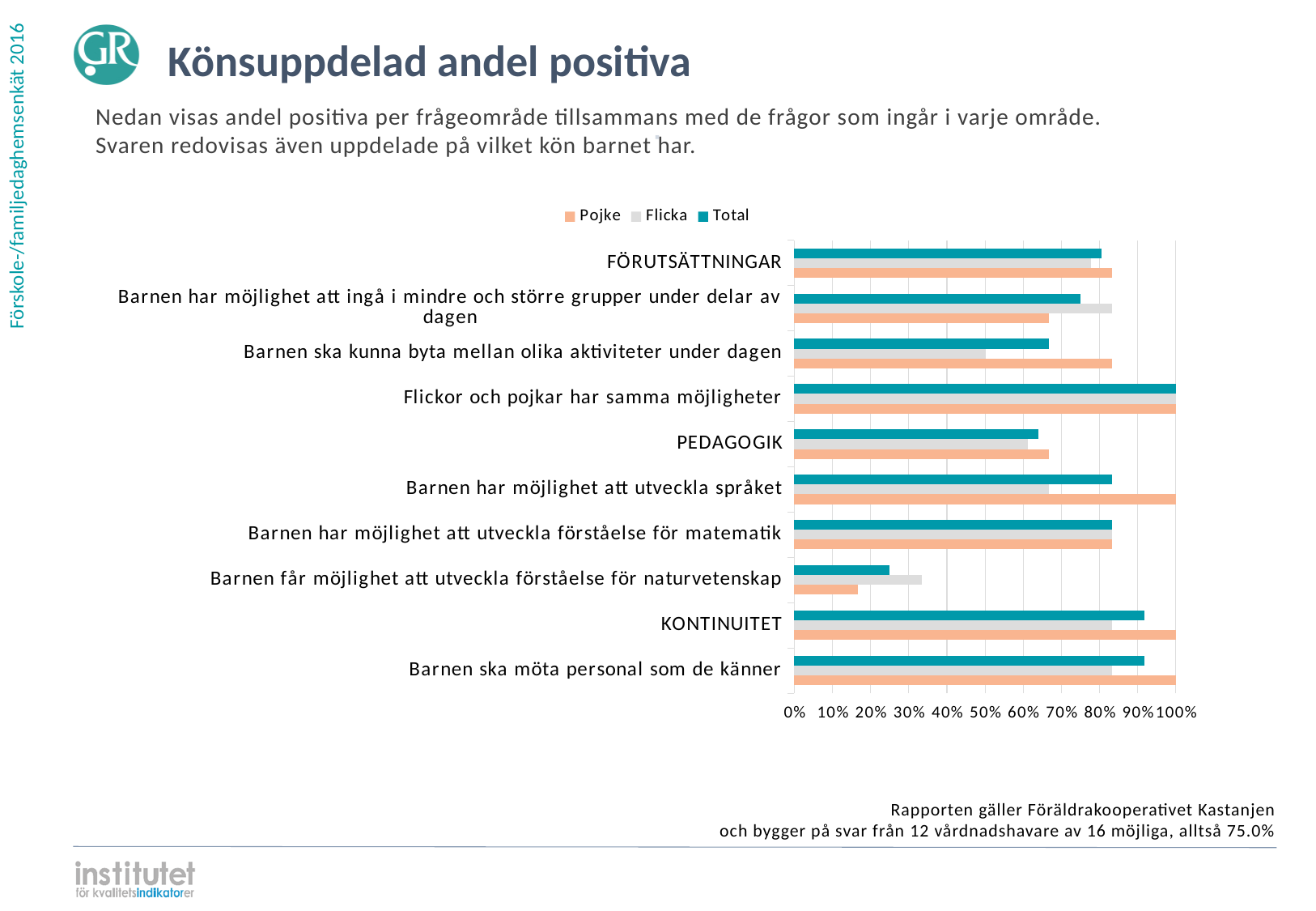
How many series does the legend list? 3 For 'Barnen ska kunna byta mellan olika aktiviteter under dagen', which is larger, the Pojke value or the Flicka value? Pojke What is the Total value for 'Flickor och pojkar har samma möjligheter'? 100% Which colour represents the Total series in the legend? teal What is the Pojke value for 'Barnen har möjlighet att utveckla språket'? 100% How many categories are plotted on the y axis of the chart? 10 Is the Total value for 'Barnen får möjlighet att utveckla förståelse för naturvetenskap' greater or less than 50%? less What kind of chart is shown on the slide? bar chart Which category has the lowest Total value? Barnen får möjlighet att utveckla förståelse för naturvetenskap Which category has the highest Total value? Flickor och pojkar har samma möjligheter Is the Total value for KONTINUITET greater or less than 80%? greater What is the Pojke value for 'Barnen ska möta personal som de känner'? 100%